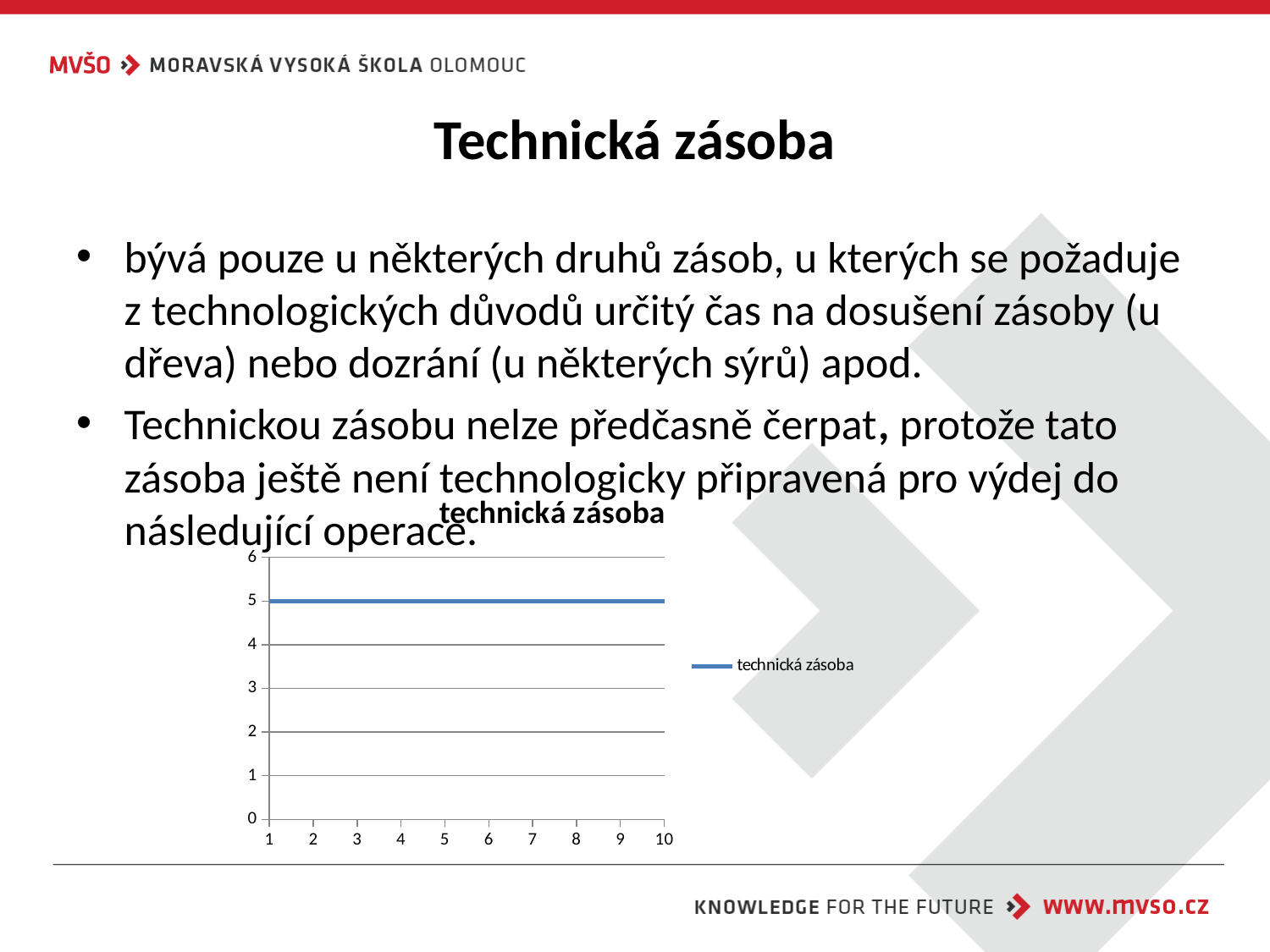
Is the value of technická zásoba at x = 7 greater or less than 6? less What kind of chart is shown on the slide? line chart What is the name of the series in the legend? technická zásoba What is the highest value shown on the y axis? 6 What is the title of the chart? technická zásoba How many points are plotted along the x axis? 10 What is the difference between the value at x = 10 and the value at x = 1? 0 Do the values of technická zásoba rise, fall or stay constant along the x axis? stay constant What is the value of technická zásoba at x = 1? 5 What is the value of technická zásoba at x = 10? 5 How many series does the legend list? 1 Is the value of technická zásoba at x = 5 greater or less than 4? greater